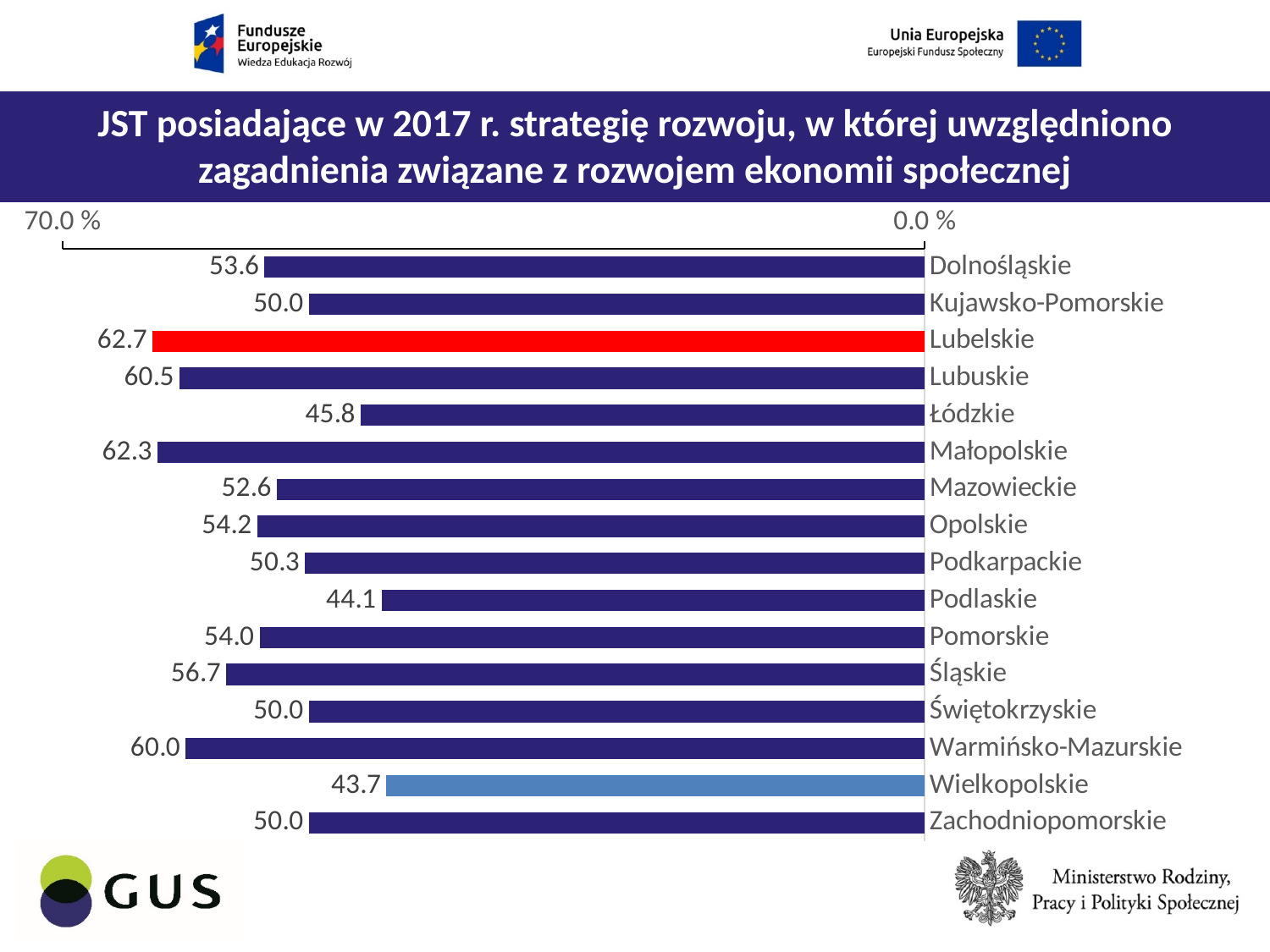
Which is larger, the value for Lubuskie or the value for Łódzkie? Lubuskie Which voivodeship has the highest value? Lubelskie What is the value for Wielkopolskie? 43.7 What is the value for Warmińsko-Mazurskie? 60.0 Which voivodeship has the lowest value? Wielkopolskie What is the difference between the values for Lubelskie and Wielkopolskie? 19.0 How many voivodeships are shown in the chart? 16 Which bar is coloured red? Lubelskie Which bar is coloured light blue? Wielkopolskie What kind of chart is shown on the slide? bar chart What is the difference between the values for Śląskie and Podlaskie? 12.6 What is the value for Lubelskie? 62.7